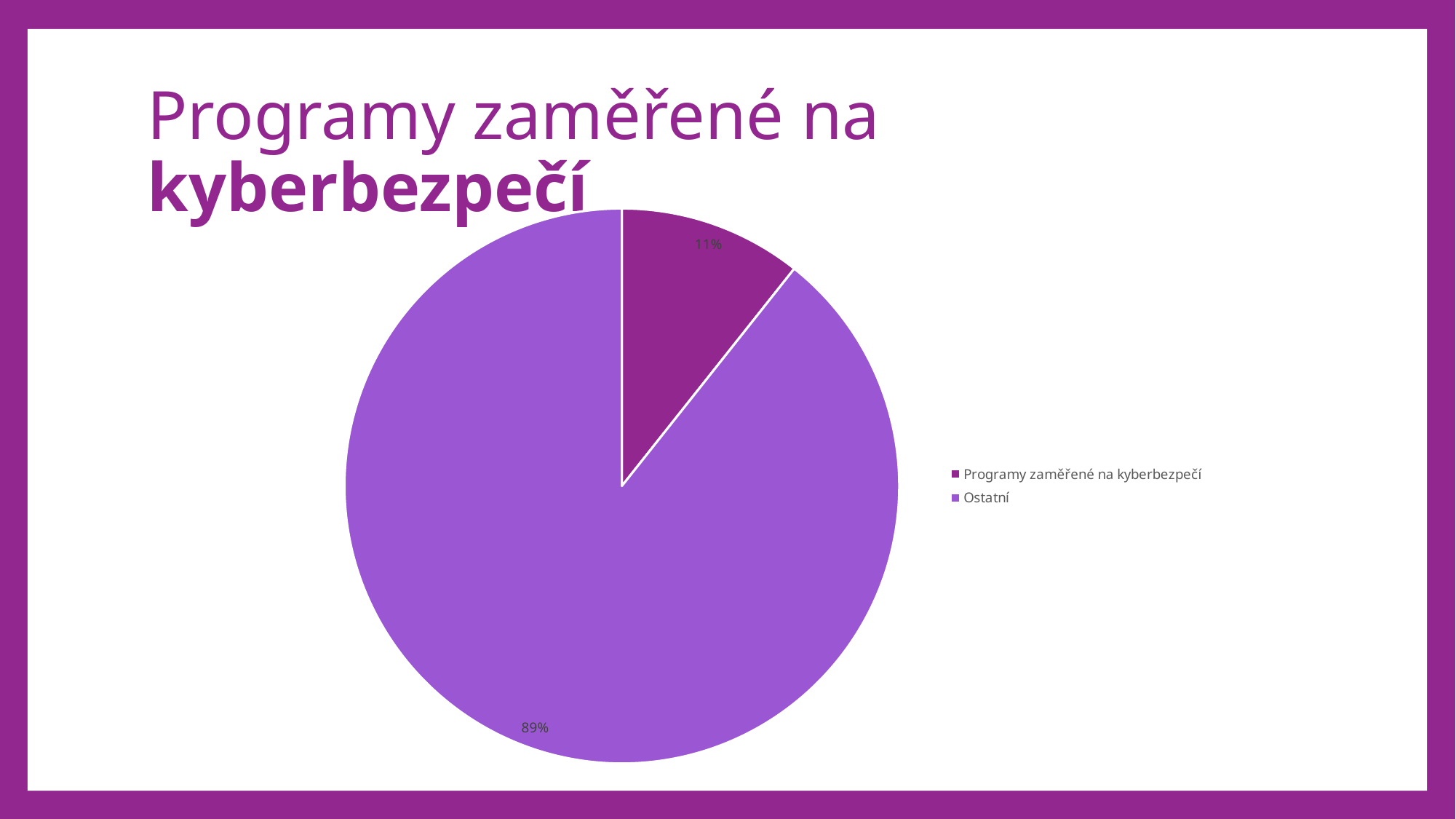
What kind of chart is shown on the slide? pie chart What is the title of the slide containing the pie chart? Programy zaměřené na kyberbezpečí What share of the pie does "Ostatní" take? 89% Which legend entry is shown in the darker purple colour? Programy zaměřené na kyberbezpečí Which slice of the pie is the largest? Ostatní Which is larger: the "Ostatní" slice or the "Programy zaměřené na kyberbezpečí" slice? Ostatní Which slice of the pie is the smallest? Programy zaměřené na kyberbezpečí What is the difference in percentage points between the "Ostatní" slice and the "Programy zaměřené na kyberbezpečí" slice? 78 How many slices does the pie chart have? 2 How many entries does the legend list? 2 What share of the pie does "Programy zaměřené na kyberbezpečí" take? 11%